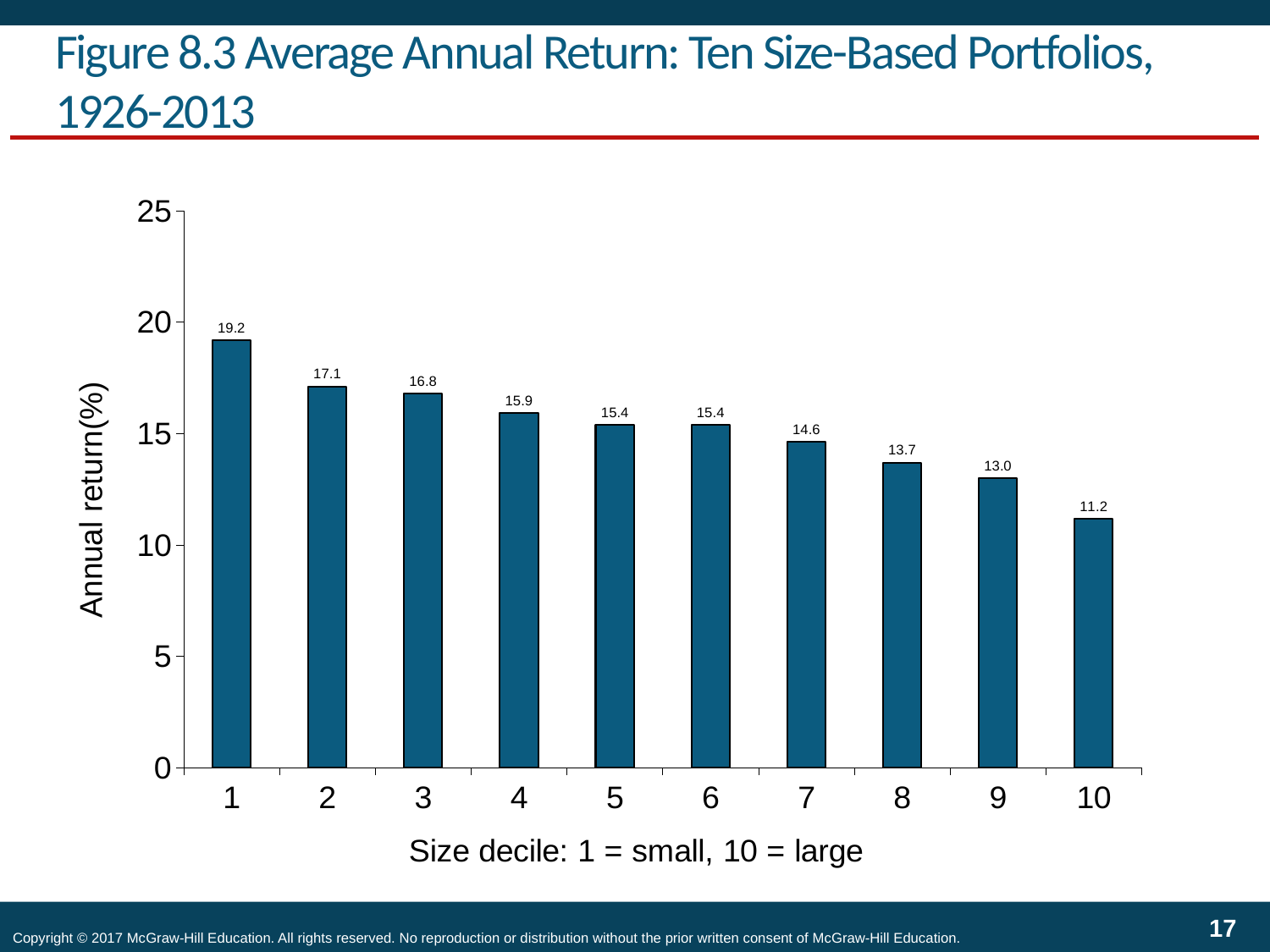
What is the annual return for size decile 10? 11.2 What is the annual return for size decile 1? 19.2 Which size decile has the lowest annual return? 10 What is the difference in annual return between decile 1 and decile 10? 8.0 Do annual returns rise or fall as the size decile increases from 1 to 10? Fall How many size deciles are shown on the chart? 10 Which size decile has the highest annual return? 1 Which has a larger annual return, decile 4 or decile 8? Decile 4 What kind of chart is shown on the slide? Bar chart What is the label of the y axis? Annual return(%) What is the annual return for size decile 7? 14.6 What is the difference in annual return between decile 2 and decile 3? 0.3